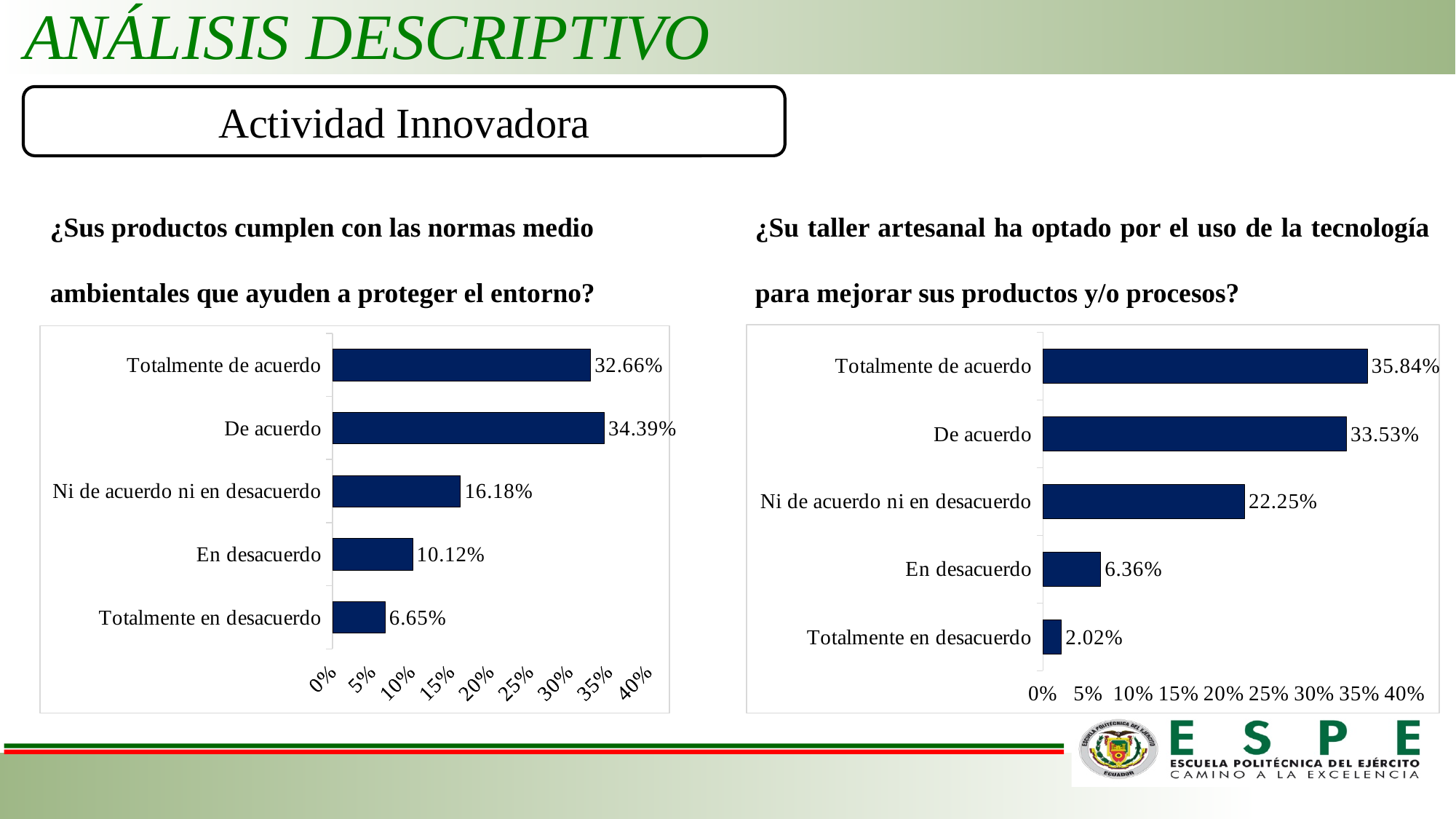
In the left chart (normas medio ambientales), which category has the highest value? De acuerdo Which is larger: "Totalmente de acuerdo" in the left chart or "Totalmente de acuerdo" in the right chart? The right chart (35.84%) In the right chart (uso de la tecnología), what is the value for "Ni de acuerdo ni en desacuerdo"? 22.25% In the right chart (uso de la tecnología), what is the value for "En desacuerdo"? 6.36% How many categories does the right chart (uso de la tecnología) show? 5 What is the maximum value shown on the x axis of the right chart (uso de la tecnología)? 40% In the left chart (normas medio ambientales), is the value for "Ni de acuerdo ni en desacuerdo" greater or less than 15%? greater In the right chart (uso de la tecnología), which category has the lowest value? Totalmente en desacuerdo In the left chart (normas medio ambientales), what is the difference between "En desacuerdo" and "Totalmente en desacuerdo"? 3.47% In the left chart (normas medio ambientales), what is the value for "De acuerdo"? 34.39% What kind of chart is the left chart (normas medio ambientales)? Bar chart In the right chart (uso de la tecnología), what is the difference between "Totalmente de acuerdo" and "De acuerdo"? 2.31%